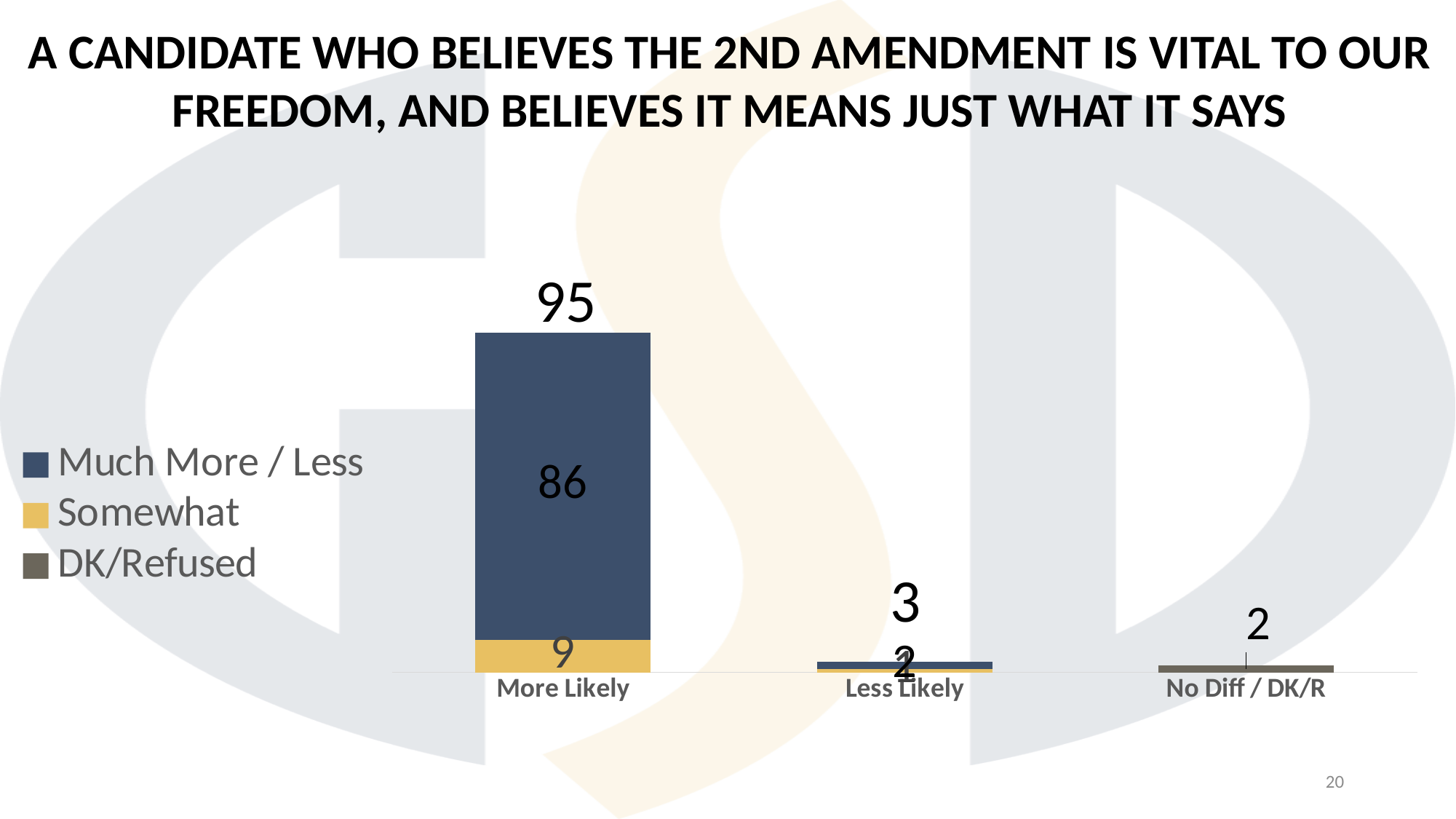
Which category has the lowest total? No Diff / DK/R What is the Much More / Less value for More Likely? 86 What is the Somewhat value for More Likely? 9 Which category has the highest total? More Likely Within the More Likely bar, which is larger: the Much More / Less segment or the Somewhat segment? Much More / Less How many series does the chart's legend list? 3 How many categories are shown on the x axis of the chart? 3 What is the total shown above the More Likely bar? 95 What is the difference between the More Likely total and the Less Likely total? 92 What kind of chart is shown on the slide? bar chart What is the value shown for No Diff / DK/R? 2 What is the total shown above the Less Likely bar? 3